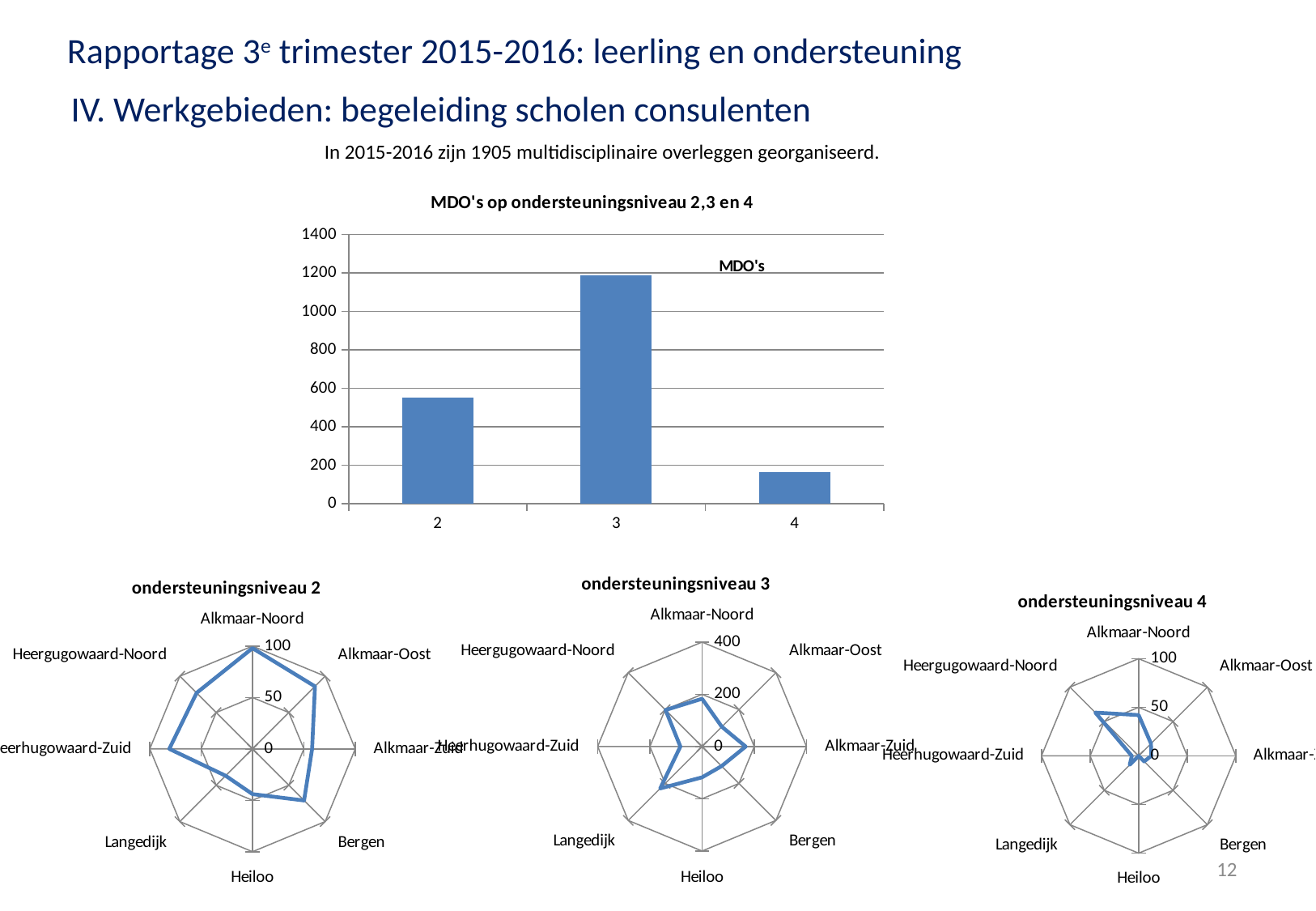
What is the name of the series shown in the chart "MDO's op ondersteuningsniveau 2,3 en 4"? MDO's In the chart "MDO's op ondersteuningsniveau 2,3 en 4", which is larger, the value for category 2 or category 4? 2 What kind of chart is the chart titled "ondersteuningsniveau 3"? radar chart How many categories are shown around the chart titled "ondersteuningsniveau 2"? 8 In the chart "MDO's op ondersteuningsniveau 2,3 en 4", how many categories are shown on the x axis? 3 In the chart "MDO's op ondersteuningsniveau 2,3 en 4", is the value for category 4 greater or less than 200? less In the chart "MDO's op ondersteuningsniveau 2,3 en 4", which category has the lowest value? 4 What kind of chart is the chart titled "MDO's op ondersteuningsniveau 2,3 en 4"? bar chart In the chart "MDO's op ondersteuningsniveau 2,3 en 4", is the value for category 3 greater or less than 1000? greater In the chart "ondersteuningsniveau 4", is the value for Bergen greater or less than 50? less In the chart "MDO's op ondersteuningsniveau 2,3 en 4", which category has the highest value? 3